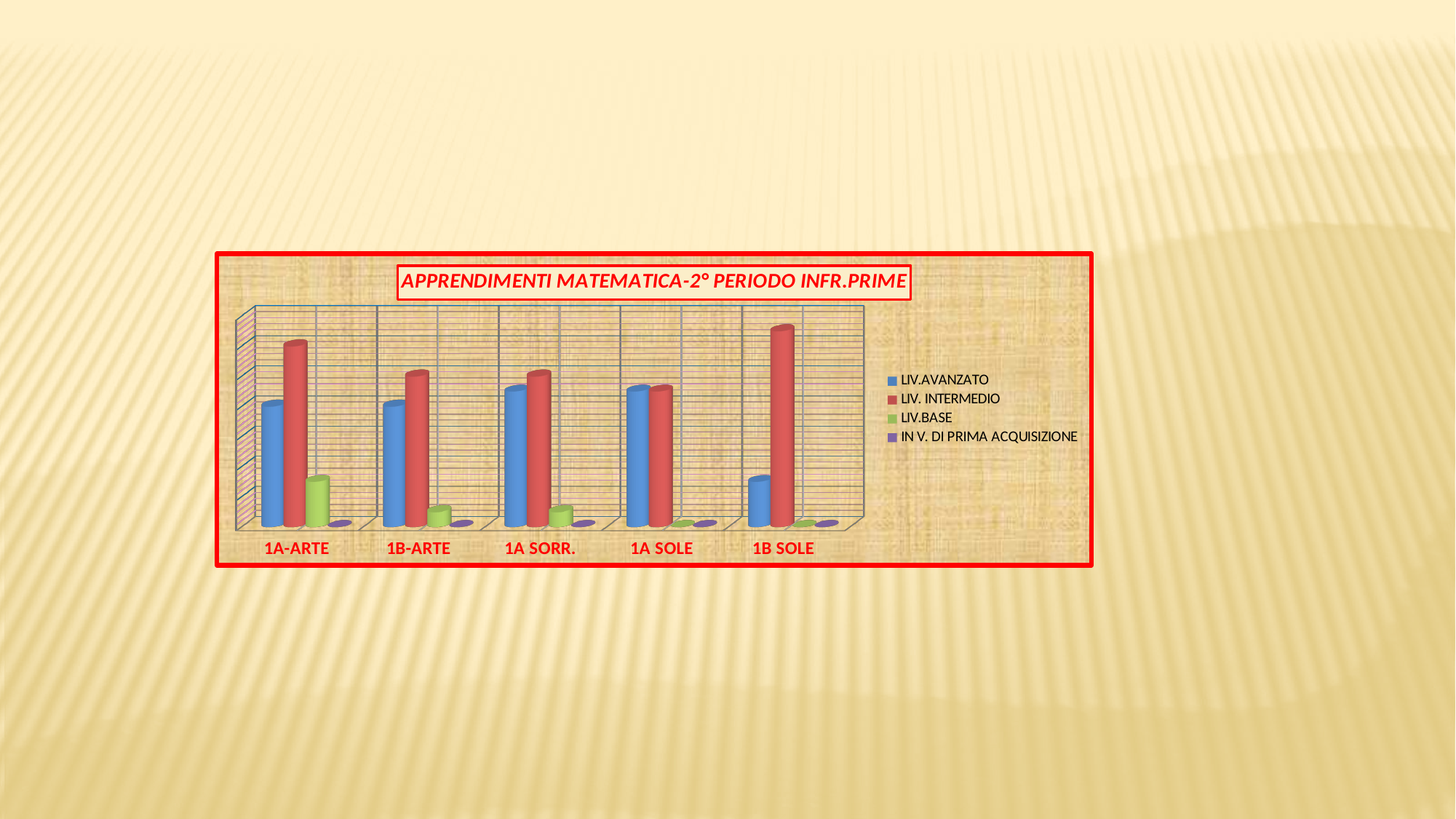
For 1A-ARTE, which is larger: LIV.AVANZATO or LIV. INTERMEDIO? LIV. INTERMEDIO Which category has the highest value for LIV. INTERMEDIO? 1B SOLE How many series does the chart's legend list? 4 Which has the larger LIV.BASE value: 1A-ARTE or 1B-ARTE? 1A-ARTE Which has the larger LIV.AVANZATO value: 1A-ARTE or 1B SOLE? 1A-ARTE Which category has the lowest value for LIV.AVANZATO? 1B SOLE What kind of chart is shown on the slide? bar chart How many categories (classes) are shown on the x axis of the chart? 5 What is the title of the chart? APPRENDIMENTI MATEMATICA-2° PERIODO INFR.PRIME Which category has the highest value for LIV.BASE? 1A-ARTE Which colour represents LIV.BASE in the chart's legend? green